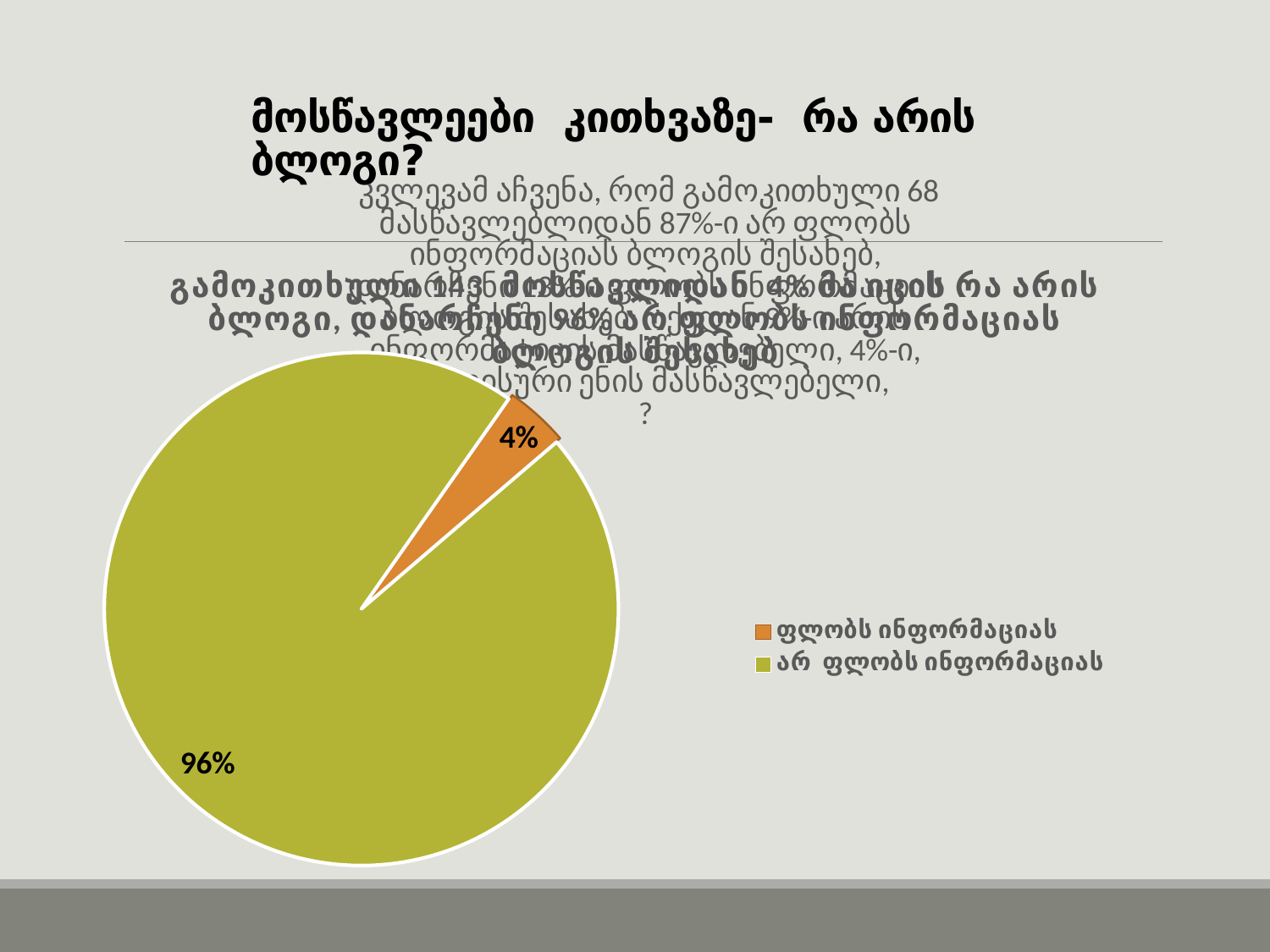
What colour is the slice for "არ ფლობს ინფორმაციას"? green Which is larger: the "ფლობს ინფორმაციას" slice or the "არ ფლობს ინფორმაციას" slice? არ ფლობს ინფორმაციას Which category has the smallest slice of the pie? ფლობს ინფორმაციას Which category has the largest slice of the pie? არ ფლობს ინფორმაციას What share of the pie does the slice labelled "არ ფლობს ინფორმაციას" represent? 96% How many slices does the pie chart have? 2 What is the difference in percentage points between the "არ ფლობს ინფორმაციას" slice and the "ფლობს ინფორმაციას" slice? 92 What colour is the slice for "ფლობს ინფორმაციას"? orange What kind of chart is shown on the slide? pie chart What is the total of the two percentages shown on the pie chart? 100% What share of the pie does the slice labelled "ფლობს ინფორმაციას" represent? 4% How many entries does the legend list? 2